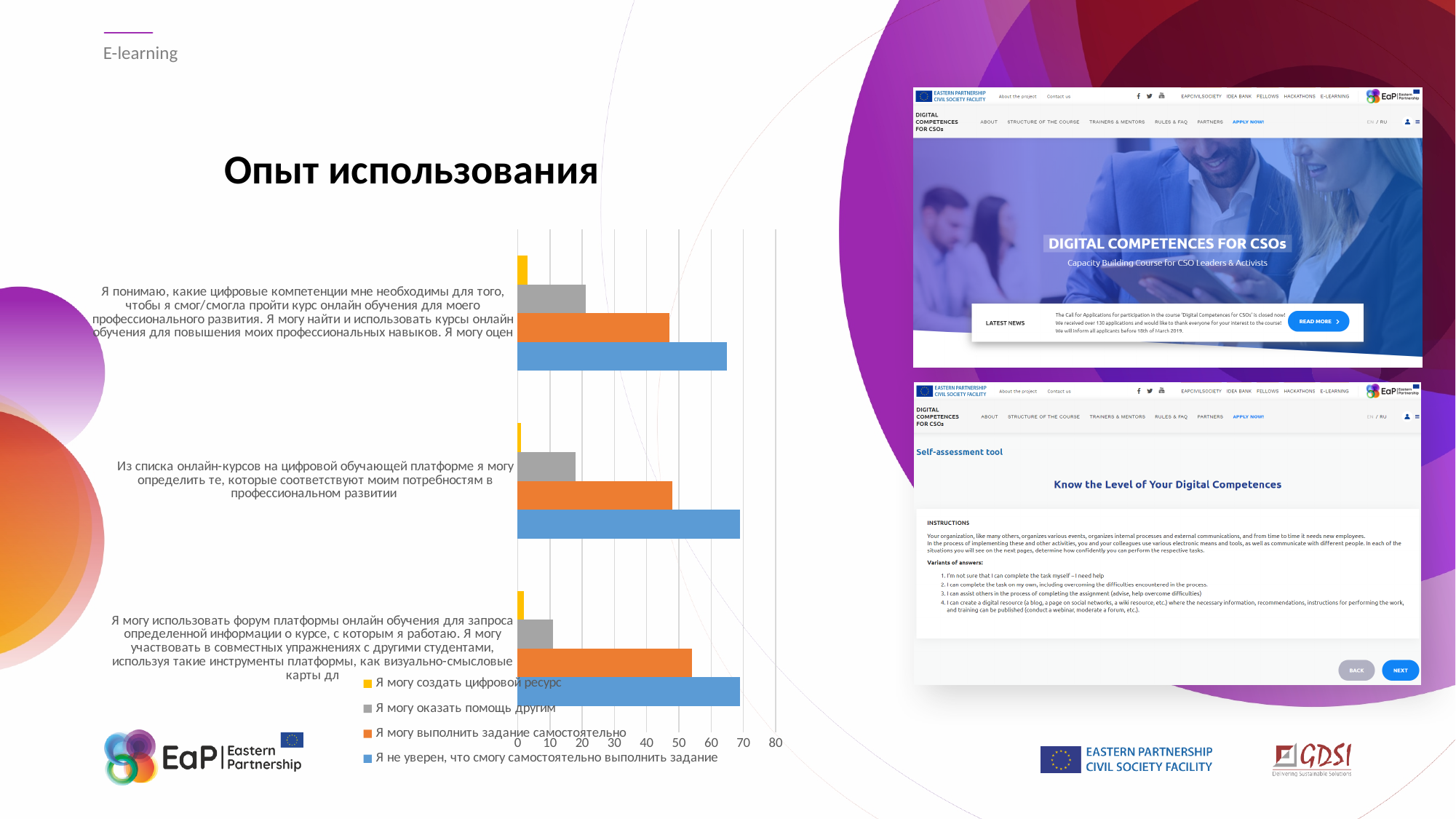
Is the value of "Я могу создать цифровой ресурс" for the middle statement ("Из списка онлайн-курсов...") greater or less than 10? less How many categories (statements) are plotted in the chart? 3 What is the title shown above the chart? Опыт использования What kind of chart is shown on the slide? Bar chart For the top statement ("Я понимаю, какие цифровые компетенции..."), which series has the longest bar? Я не уверен, что смогу самостоятельно выполнить задание How many series does the chart legend list? 4 For the middle statement ("Из списка онлайн-курсов..."), which is larger: "Я могу выполнить задание самостоятельно" or "Я могу оказать помощь другим"? Я могу выполнить задание самостоятельно Is the value of "Я могу оказать помощь другим" for the bottom statement ("Я могу использовать форум...") greater or less than 20? less Is the value of "Я могу выполнить задание самостоятельно" for the bottom statement ("Я могу использовать форум...") greater or less than 50? greater For the top statement ("Я понимаю, какие цифровые компетенции..."), which series has the shortest bar? Я могу создать цифровой ресурс Which legend entry is shown in blue? Я не уверен, что смогу самостоятельно выполнить задание